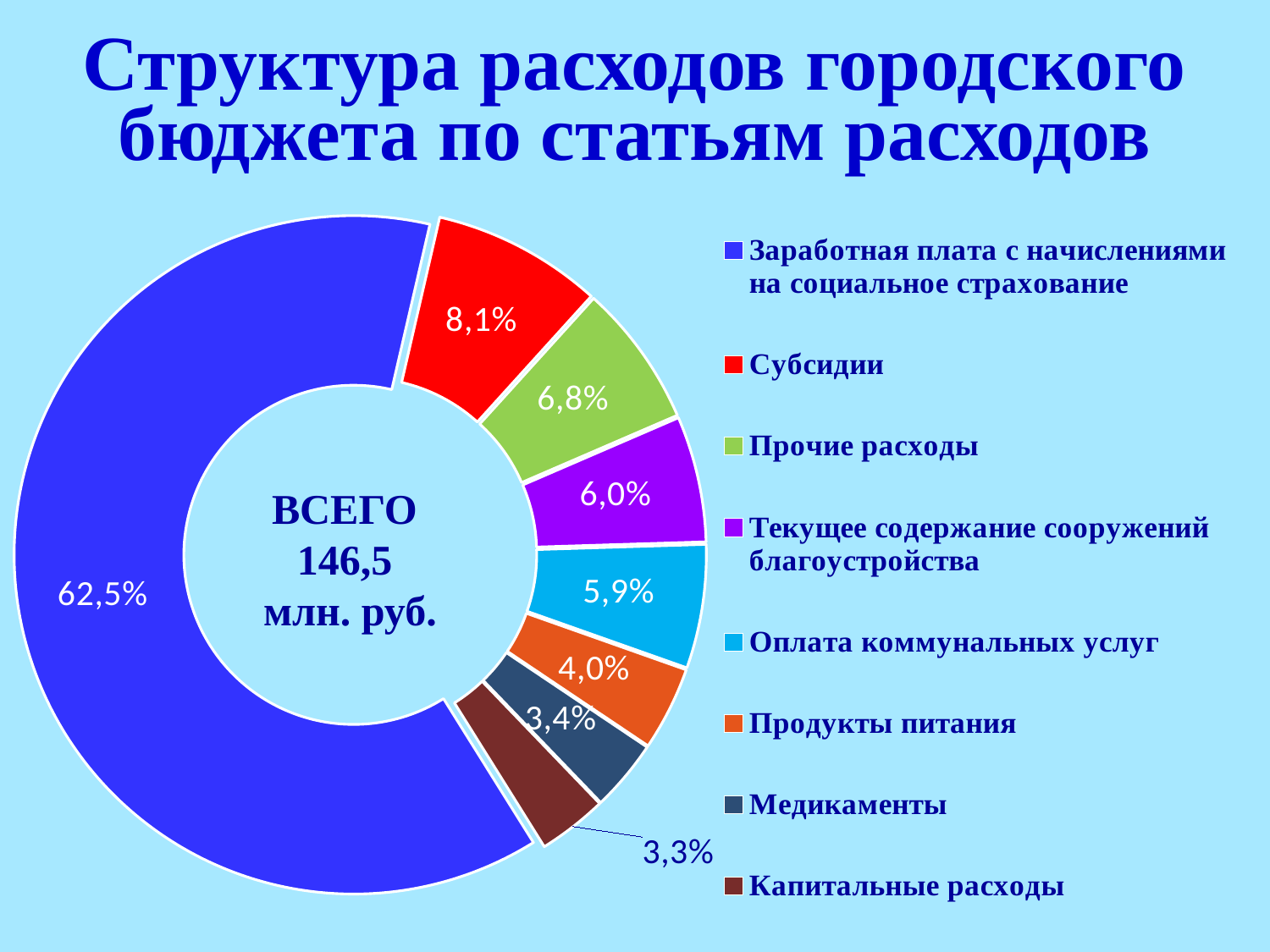
Which expense item has the largest share of the budget? Заработная плата с начислениями на социальное страхование Which is larger: the share for Продукты питания or the share for Текущее содержание сооружений благоустройства? Текущее содержание сооружений благоустройства What percentage is shown for Субсидии? 8,1% What colour represents Медикаменты in the chart? Dark blue What percentage of expenses is Капитальные расходы? 3,3% What total amount is shown in the centre of the chart? 146,5 млн. руб. Which expense item has the smallest share of the budget? Капитальные расходы What is the value for Оплата коммунальных услуг? 5,9% What share of the city budget expenses goes to Заработная плата с начислениями на социальное страхование? 62,5% What is the difference in percentage points between Субсидии and Прочие расходы? 1,3 What type of chart is used on the slide? Doughnut (pie) chart How many expense categories are shown in the chart? 8